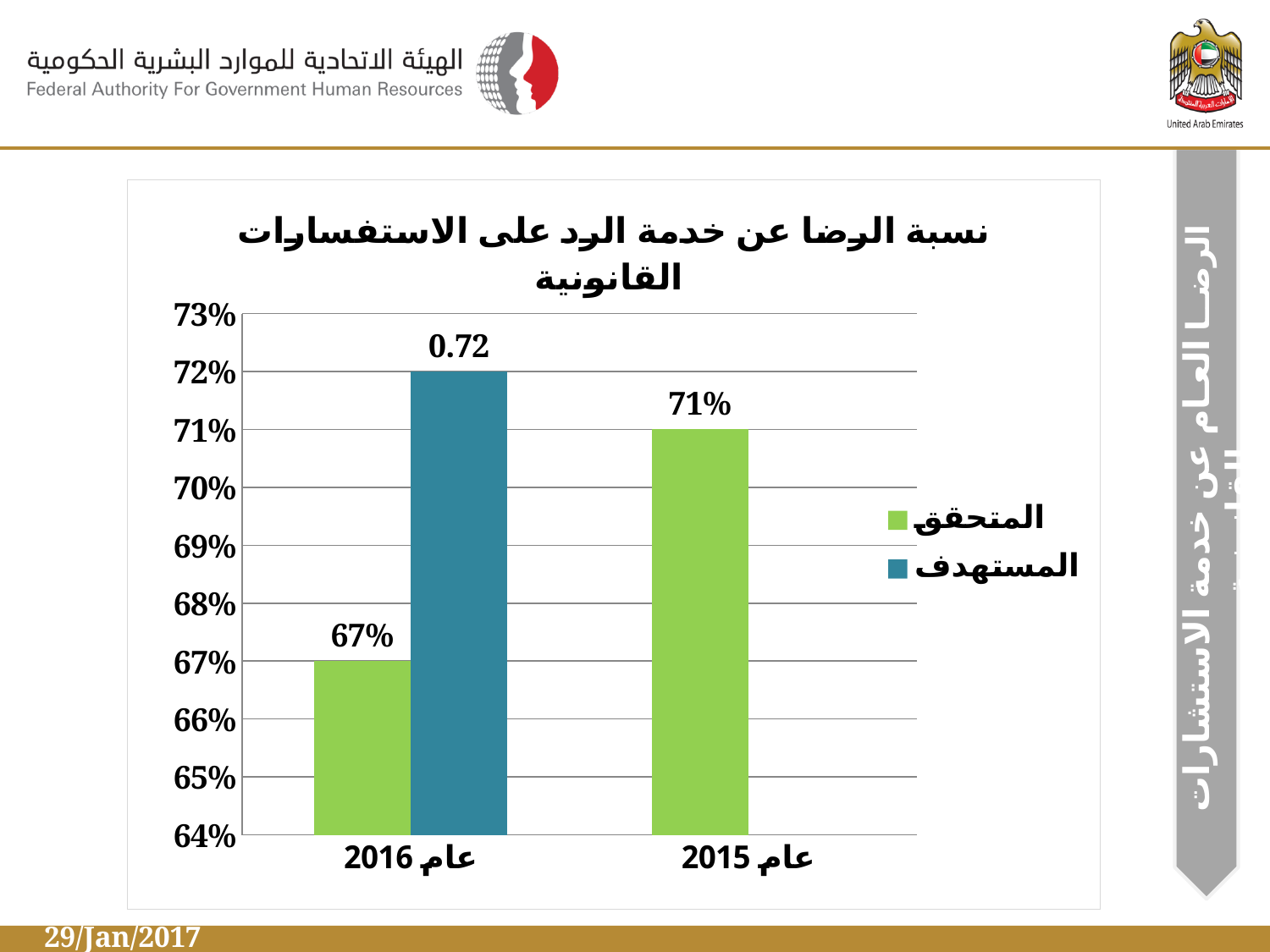
Which bar on the chart is the tallest? المستهدف for عام 2016 Is the المتحقق value for عام 2016 greater or less than 70%? less What is the difference between the المتحقق value for عام 2015 and the المتحقق value for عام 2016? 4 percentage points Which year has the higher المتحقق value, عام 2016 or عام 2015? عام 2015 What type of chart is shown on the slide? Bar chart How many series does the legend list? 2 Which bar on the chart is the shortest? المتحقق for عام 2016 What is the value of المتحقق for عام 2015? 71% What data label is shown on the المستهدف bar for عام 2016? 0.72 What is the value of المتحقق for عام 2016? 67% How many year categories are shown on the x axis? 2 What colour are the المتحقق bars? Green